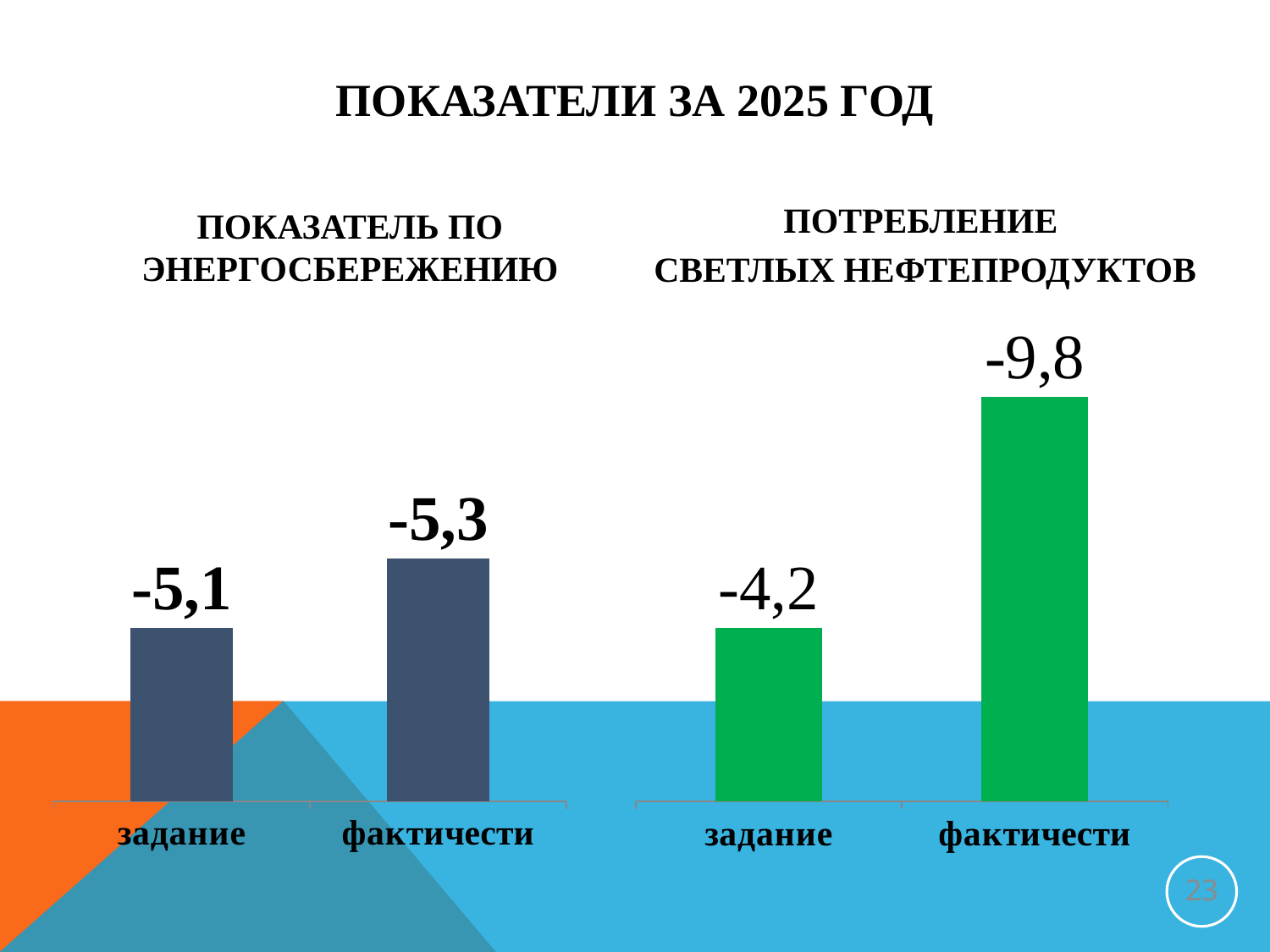
How many categories does the right chart (ПОТРЕБЛЕНИЕ СВЕТЛЫХ НЕФТЕПРОДУКТОВ) show? 2 In the left chart (ПОКАЗАТЕЛЬ ПО ЭНЕРГОСБЕРЕЖЕНИЮ), what is the value for задание? -5,1 What colour are the bars in the right chart (ПОТРЕБЛЕНИЕ СВЕТЛЫХ НЕФТЕПРОДУКТОВ)? green In the right chart (ПОТРЕБЛЕНИЕ СВЕТЛЫХ НЕФТЕПРОДУКТОВ), what is the value for фактичести? -9,8 In the right chart (ПОТРЕБЛЕНИЕ СВЕТЛЫХ НЕФТЕПРОДУКТОВ), which category has the taller bar? фактичести In the right chart (ПОТРЕБЛЕНИЕ СВЕТЛЫХ НЕФТЕПРОДУКТОВ), what is the difference between the values for фактичести and задание? 5,6 In the left chart (ПОКАЗАТЕЛЬ ПО ЭНЕРГОСБЕРЕЖЕНИЮ), what is the value for фактичести? -5,3 What kind of chart is the left chart (ПОКАЗАТЕЛЬ ПО ЭНЕРГОСБЕРЕЖЕНИЮ)? bar chart In the right chart (ПОТРЕБЛЕНИЕ СВЕТЛЫХ НЕФТЕПРОДУКТОВ), what is the value for задание? -4,2 In the left chart (ПОКАЗАТЕЛЬ ПО ЭНЕРГОСБЕРЕЖЕНИЮ), which category has the shorter bar? задание What is the title of the slide? ПОКАЗАТЕЛИ ЗА 2025 ГОД In the left chart (ПОКАЗАТЕЛЬ ПО ЭНЕРГОСБЕРЕЖЕНИЮ), what is the difference between the values for фактичести and задание? 0,2